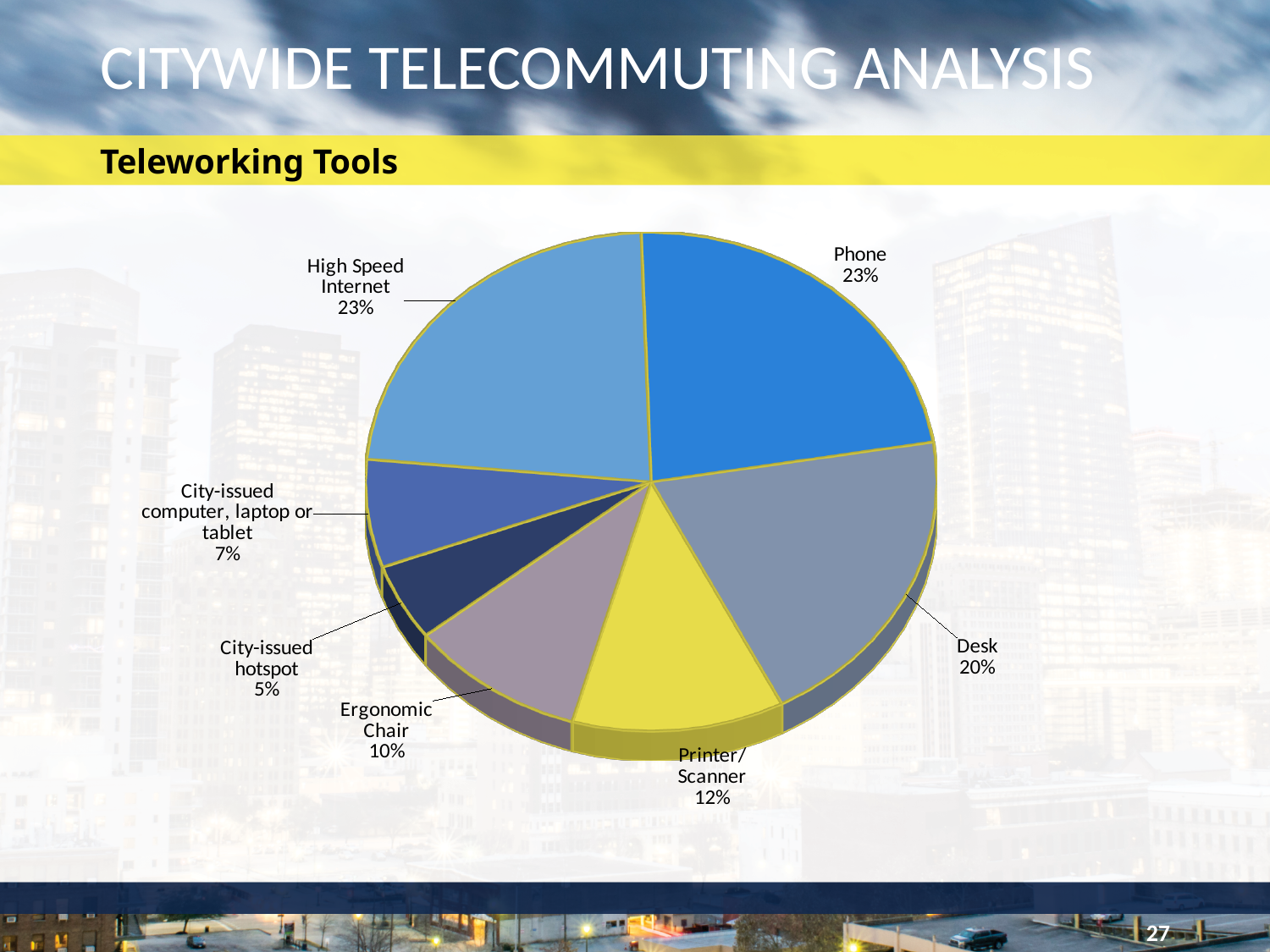
Which is larger, Printer/Scanner or Ergonomic Chair? Printer/Scanner What is the value shown for Ergonomic Chair? 10% What is the difference in percentage points between Phone and Desk? 3 What is the title shown above the pie chart? Teleworking Tools What is the value for City-issued computer, laptop or tablet? 7% Which category has the smallest slice of the pie? City-issued hotspot How many slices does the pie chart have? 7 What is the difference in percentage points between High Speed Internet and City-issued hotspot? 18 What percentage of the pie is Desk? 20% What kind of chart is shown on the slide? Pie chart What percentage is shown for City-issued hotspot? 5% What share does Printer/Scanner have in the pie chart? 12%